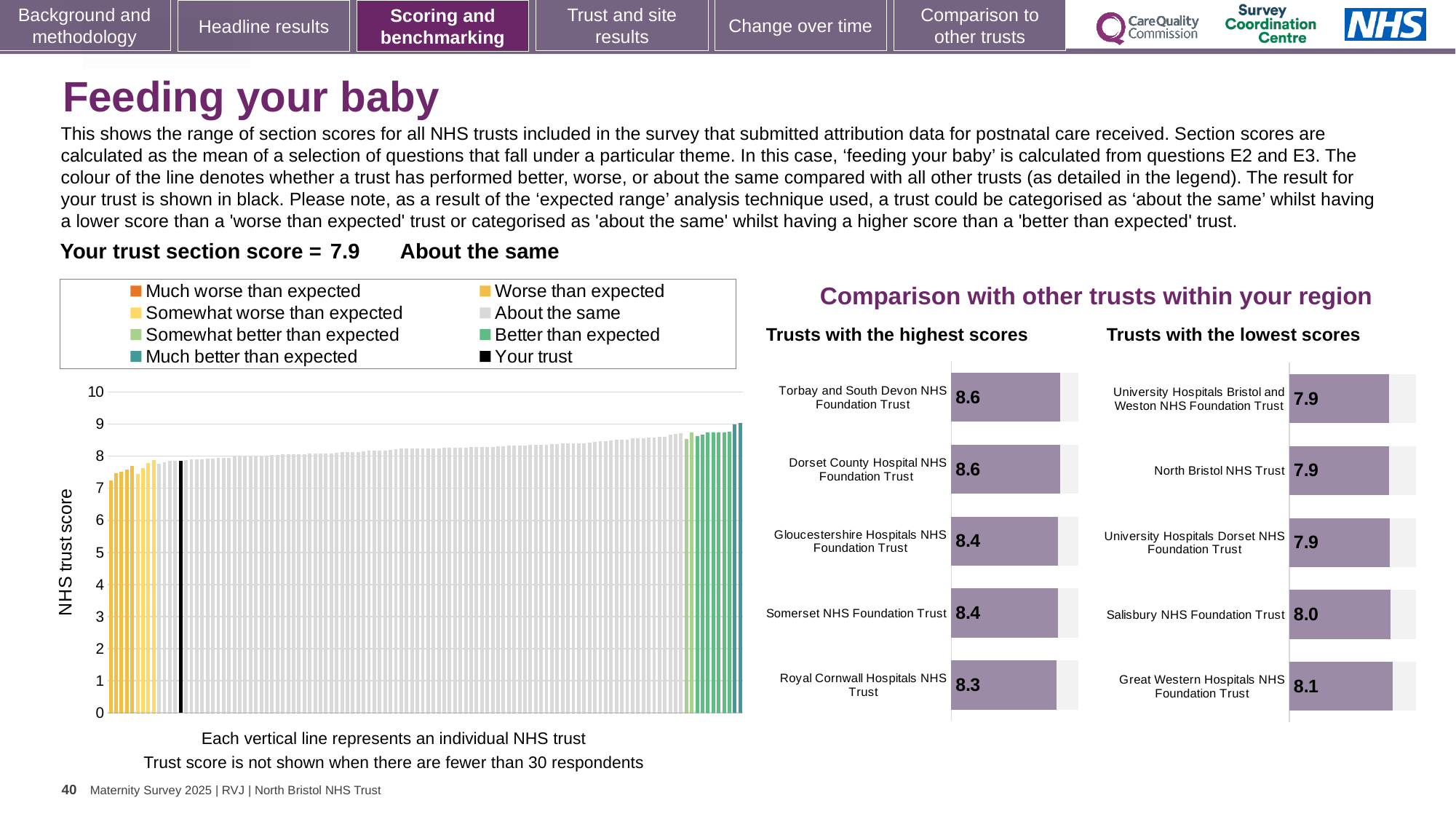
How many trusts are shown in the 'Trusts with the lowest scores' chart? 5 In the 'Trusts with the highest scores' chart, which has the larger score: Gloucestershire Hospitals NHS Foundation Trust or Royal Cornwall Hospitals NHS Trust? Gloucestershire Hospitals NHS Foundation Trust What kind of chart is the 'NHS trust score' chart on the left of the slide? Bar chart In the 'Trusts with the highest scores' chart, what is the difference between the scores of Torbay and South Devon NHS Foundation Trust and Royal Cornwall Hospitals NHS Trust? 0.3 In the 'NHS trust score' chart on the left, is the value of the tallest bar greater or less than 8? greater In the 'Trusts with the highest scores' chart, what is the score for Torbay and South Devon NHS Foundation Trust? 8.6 In the 'Trusts with the lowest scores' chart, which trust has the highest score? Great Western Hospitals NHS Foundation Trust In the 'Trusts with the highest scores' chart, what is the score for Royal Cornwall Hospitals NHS Trust? 8.3 How many entries does the legend of the 'NHS trust score' chart on the left list? 8 In the 'Trusts with the lowest scores' chart, what is the score for Salisbury NHS Foundation Trust? 8.0 In the 'Trusts with the lowest scores' chart, what is the difference between the scores of Great Western Hospitals NHS Foundation Trust and Salisbury NHS Foundation Trust? 0.1 In the 'NHS trust score' chart on the left, do the bar values rise or fall from left to right? Rise